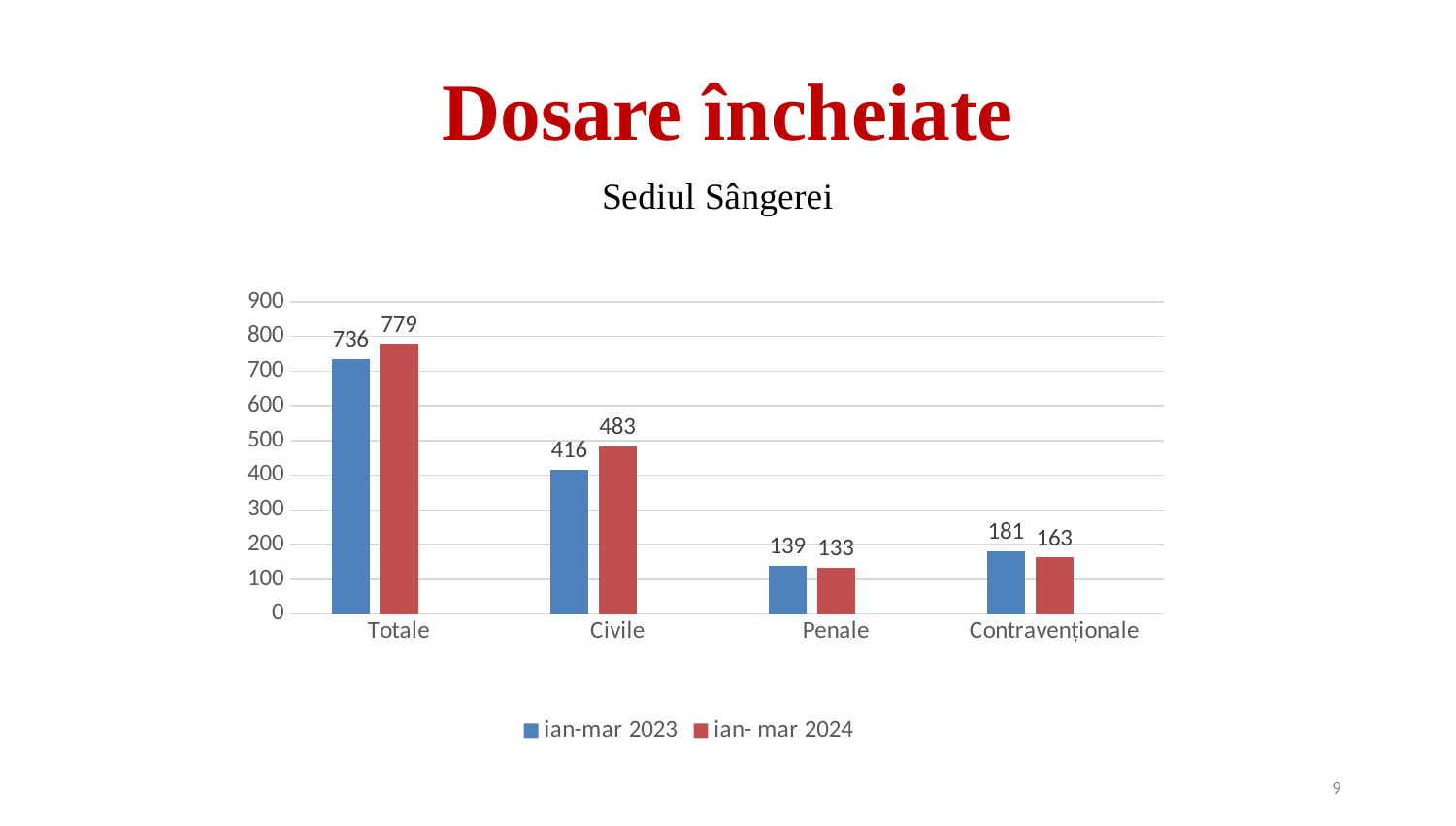
Which category has the lowest value in the ian- mar 2024 series? Penale What is the value for Totale in the ian-mar 2023 series? 736 What is the value for Penale in the ian-mar 2023 series? 139 What is the value for Contravenționale in the ian- mar 2024 series? 163 What is the difference between the ian- mar 2024 and ian-mar 2023 values for Civile? 67 What is the value for Civile in the ian- mar 2024 series? 483 Which category has the highest value in the ian-mar 2023 series? Totale What is the subtitle shown above the chart? Sediul Sângerei How many categories are shown on the x axis? 4 What kind of chart is shown on the slide? Bar chart How many series does the legend list? 2 Which is larger for Penale: the ian-mar 2023 value or the ian- mar 2024 value? ian-mar 2023